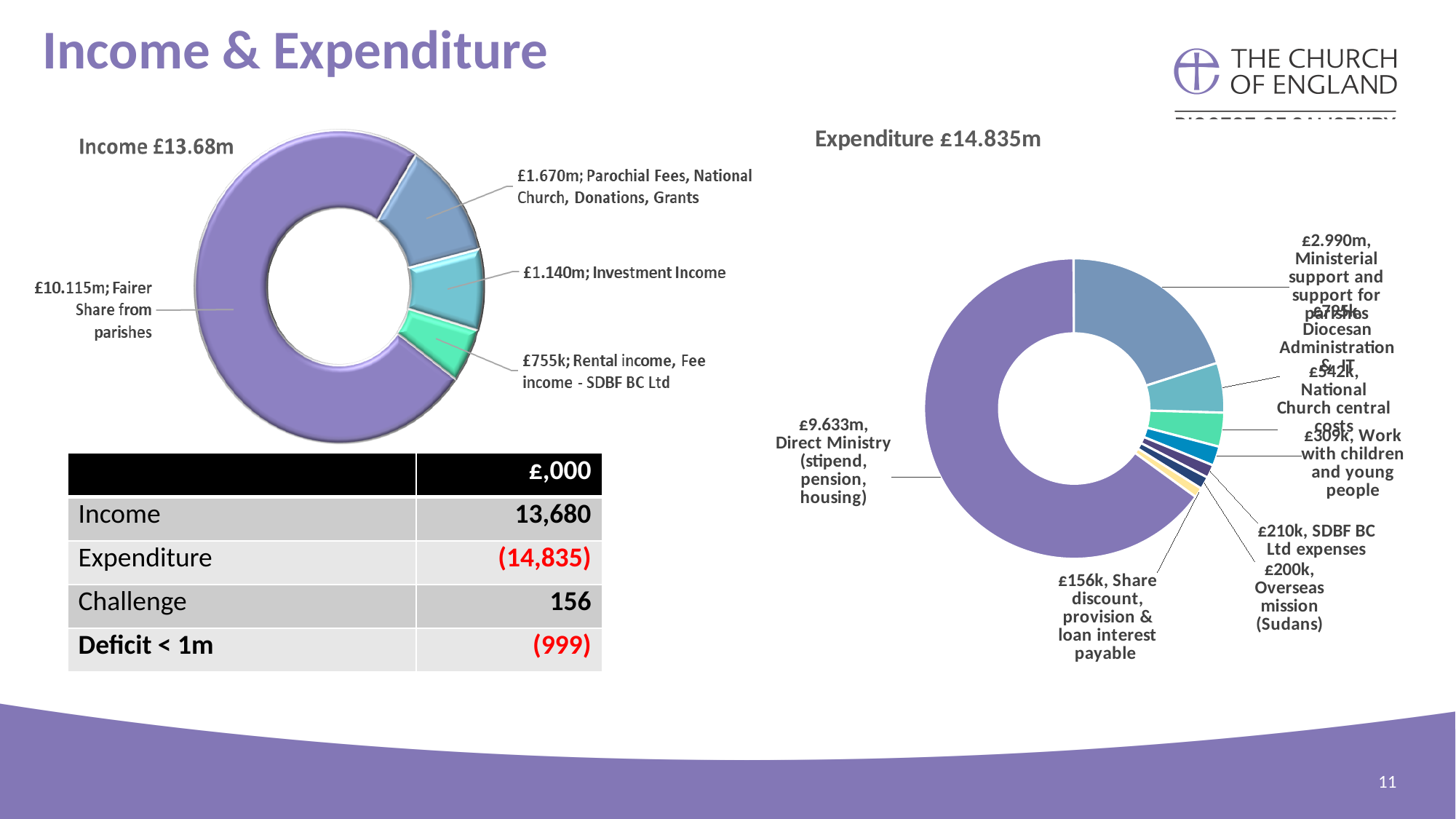
In the Expenditure £14.835m chart, what is the value for Direct Ministry (stipend, pension, housing)? £9.633m In the Expenditure £14.835m chart, which category is the smallest? Share discount, provision & loan interest payable What type of chart is used to show Income £13.68m? Donut (pie) chart In the Income £13.68m chart, what is the value for Rental income, Fee income - SDBF BC Ltd? £755k In the Expenditure £14.835m chart, what is the value for Overseas mission (Sudans)? £200k In the Income £13.68m chart, what is the value for Investment Income? £1.140m In the Income £13.68m chart, what is the value for Fairer Share from parishes? £10.115m In the Expenditure £14.835m chart, which is larger: SDBF BC Ltd expenses or Work with children and young people? Work with children and young people How many slices does the Income £13.68m chart have? 4 In the Income £13.68m chart, which category is the largest? Fairer Share from parishes In the Expenditure £14.835m chart, what is the value for Ministerial support and support for parishes? £2.990m In the Income £13.68m chart, which category is the smallest? Rental income, Fee income - SDBF BC Ltd